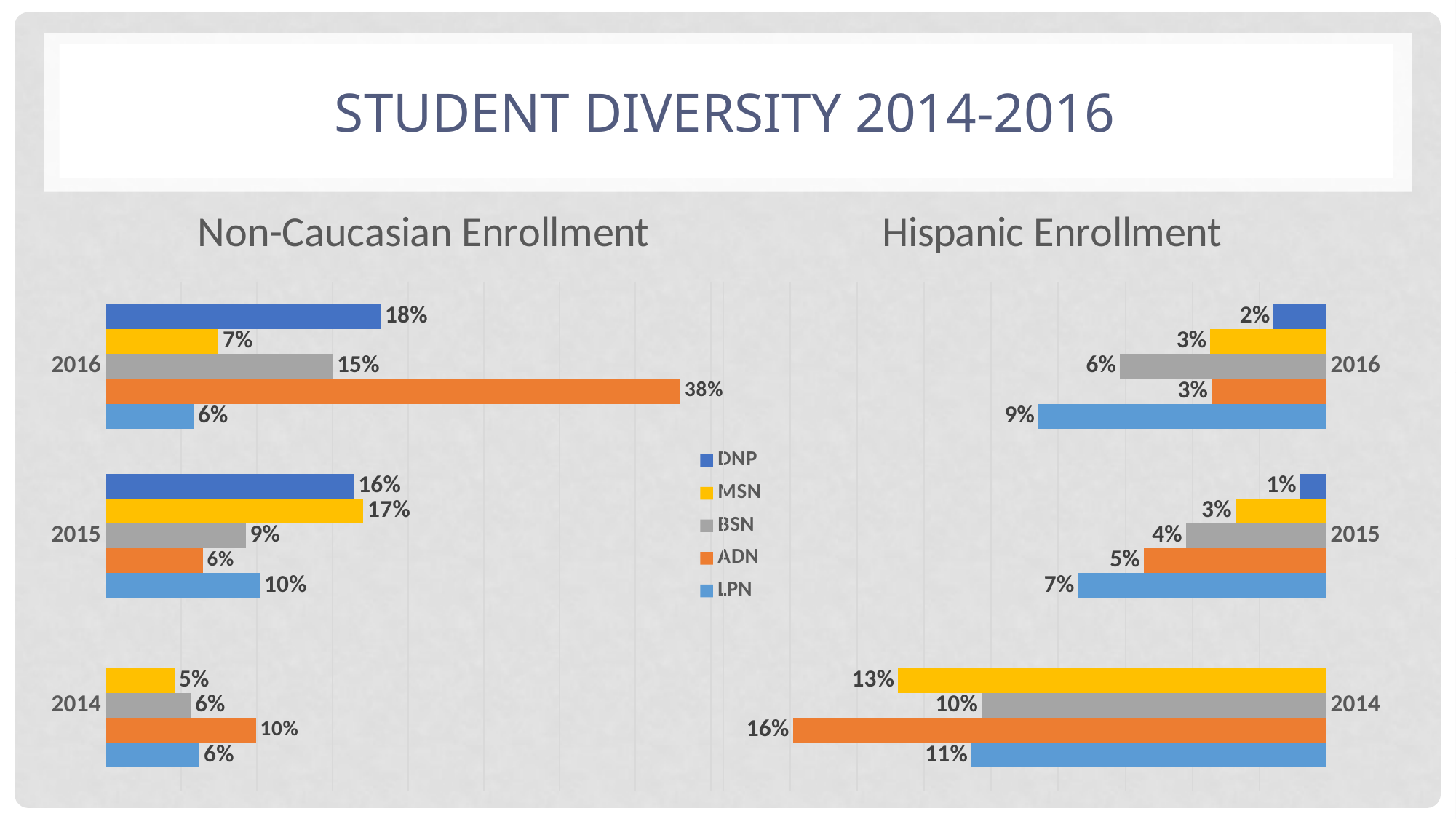
In the Non-Caucasian Enrollment chart, which program has the highest value in 2016? ADN In the Non-Caucasian Enrollment chart, what is the difference between the ADN value and the DNP value in 2016? 20% In the Hispanic Enrollment chart, which is larger in 2015: the LPN value or the ADN value? LPN In the Hispanic Enrollment chart, which program has the lowest value in 2016? DNP In the Non-Caucasian Enrollment chart, what is the value for ADN in 2016? 38% In the Hispanic Enrollment chart, what is the value for LPN in 2014? 11% In the Non-Caucasian Enrollment chart, how many years are shown on the axis? 3 What kind of chart is the Non-Caucasian Enrollment chart? Bar chart In the Hispanic Enrollment chart, what is the value for DNP in 2015? 1% In the Hispanic Enrollment chart, what is the difference between the ADN value and the BSN value in 2014? 6% In the Non-Caucasian Enrollment chart, what is the value for MSN in 2015? 17% How many series does the legend list? 5